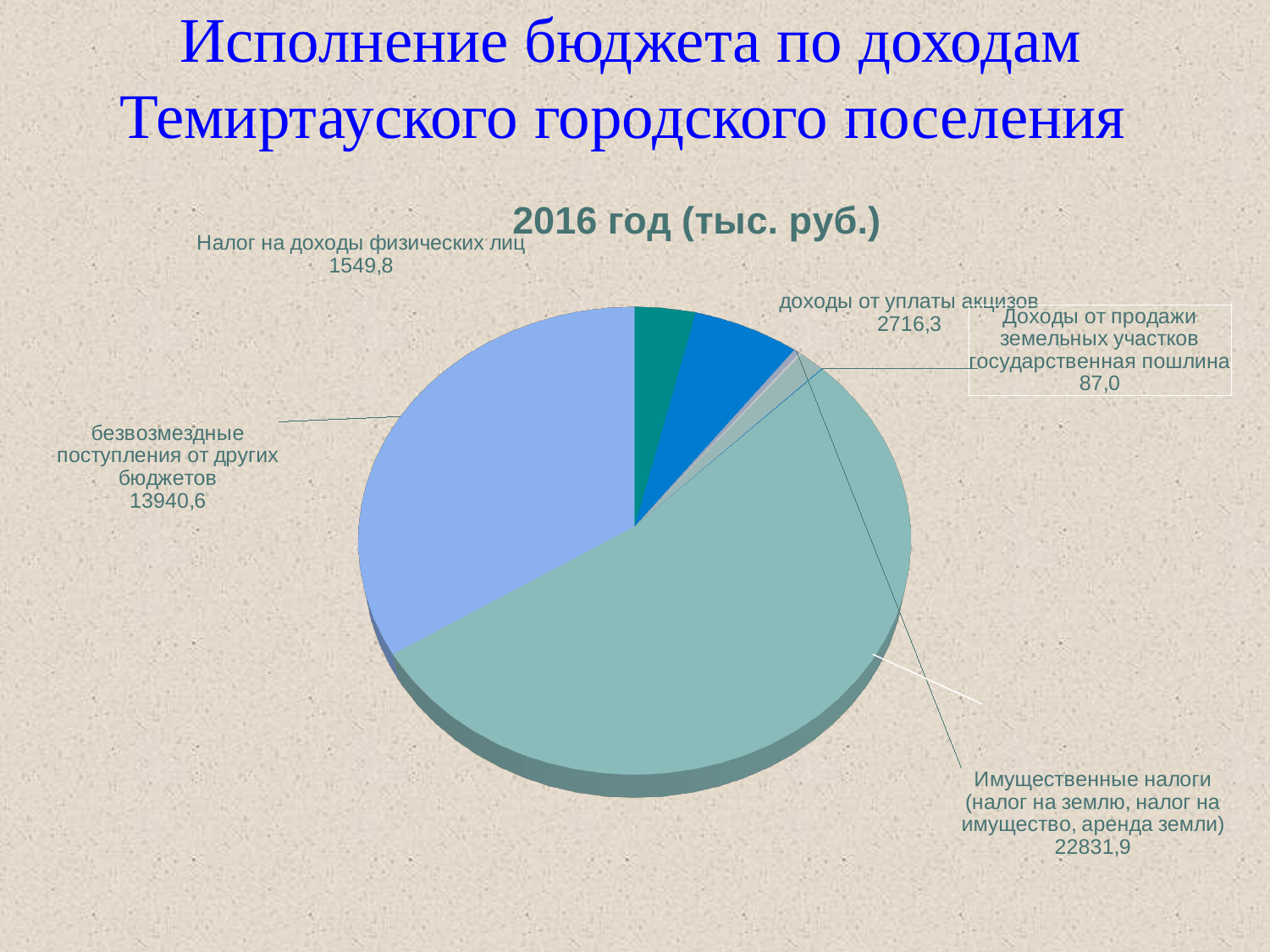
How many categories are labelled on the pie chart? 5 What is the value for государственная пошлина? 87,0 What is the value for безвозмездные поступления от других бюджетов? 13940,6 Which is larger: доходы от уплаты акцизов or Налог на доходы физических лиц? доходы от уплаты акцизов What is the value for Налог на доходы физических лиц? 1549,8 What is the value for Имущественные налоги (налог на землю, налог на имущество, аренда земли)? 22831,9 What is the difference between доходы от уплаты акцизов and Налог на доходы физических лиц? 1166,5 What is the title of the chart? 2016 год (тыс. руб.) Which category has the highest value? Имущественные налоги (налог на землю, налог на имущество, аренда земли) What type of chart is shown on the slide? pie chart What is the value for доходы от уплаты акцизов? 2716,3 What is the difference between Имущественные налоги and безвозмездные поступления от других бюджетов? 8891,3